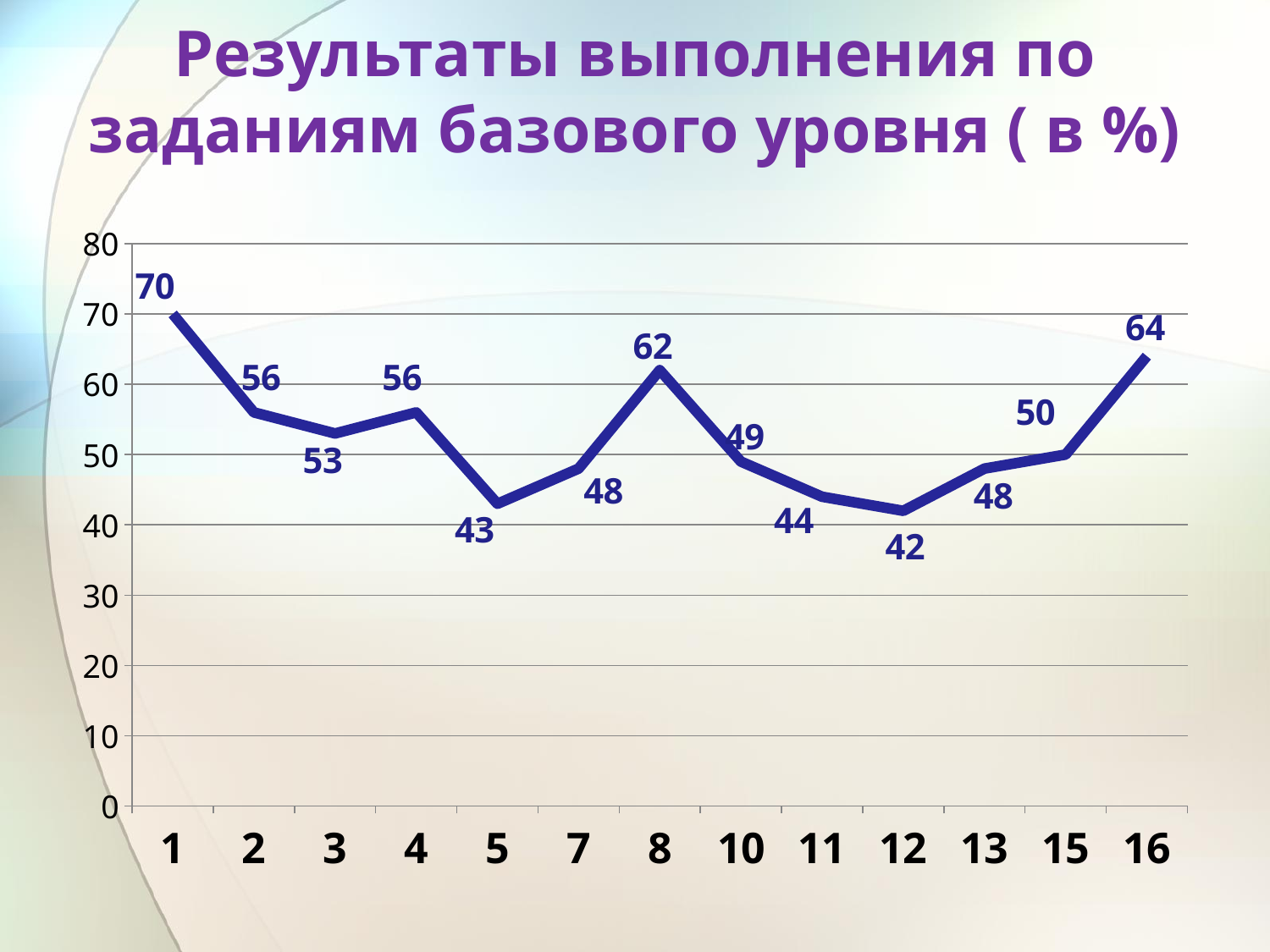
Which task has the lowest value? 12 How many tasks are plotted on the chart? 13 What is the value for task 12? 42 Which is larger, the value for task 8 or the value for task 4? task 8 What is the value for task 8? 62 What is the value for task 1? 70 What is the value for task 16? 64 What is the difference between the values for task 1 and task 12? 28 What is the difference between the values for task 16 and task 5? 21 What is the title of the chart? Результаты выполнения по заданиям базового уровня ( в %) Which task has the highest value? 1 What type of chart is shown on the slide? line chart